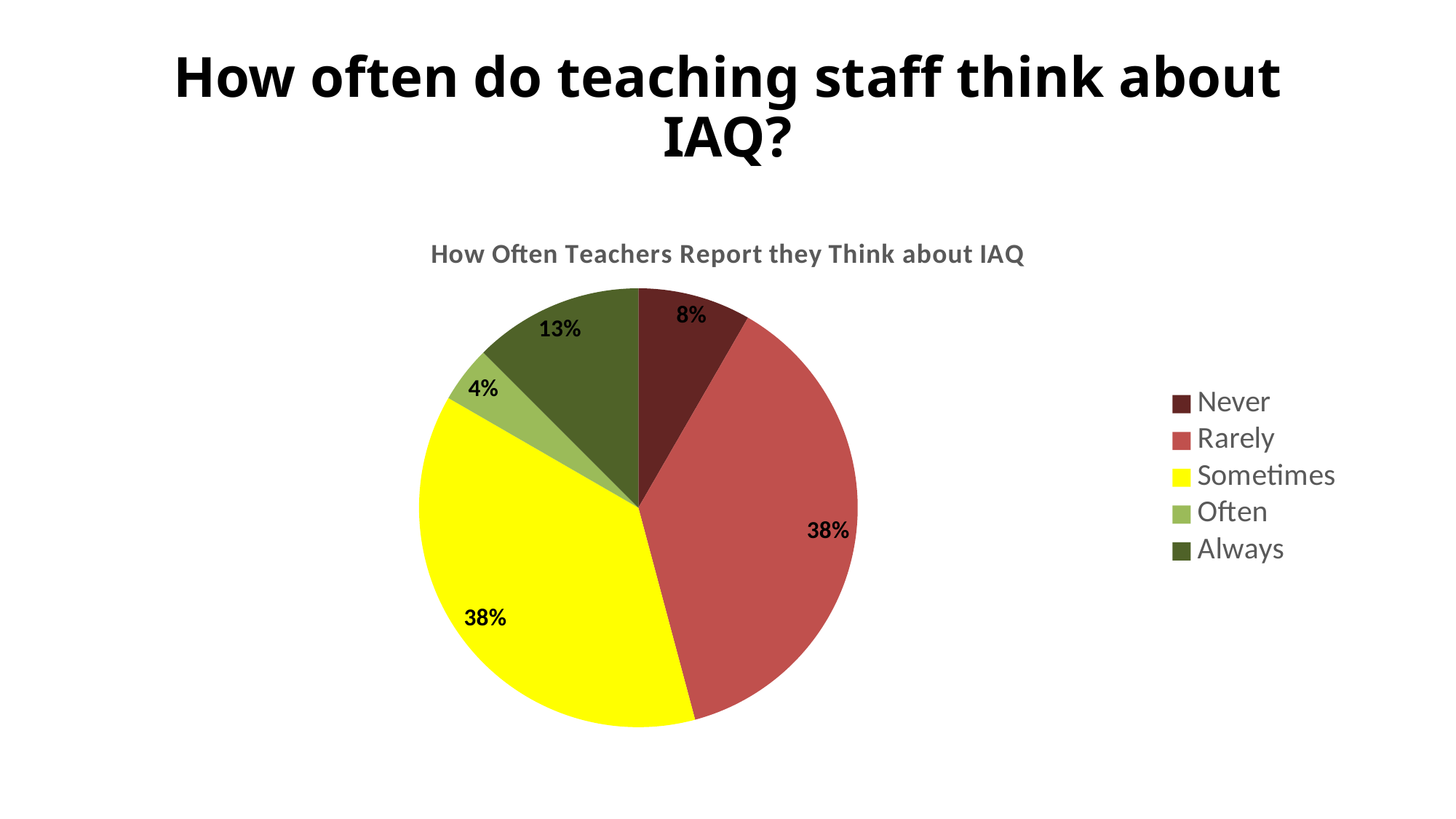
What is the chart's title? How Often Teachers Report they Think about IAQ What colour is the Sometimes slice? yellow What is the difference in percentage points between the Sometimes and Often slices? 34 Which category has the smallest share of the pie? Often What percentage of teachers report they Never think about IAQ? 8% What is the difference in percentage points between the Always and Never slices? 5 What kind of chart is shown on the slide? pie chart What percentage of teachers report they Always think about IAQ? 13% How many categories does the legend list? 5 What percentage of teachers report they Rarely think about IAQ? 38% What percentage of teachers report they Often think about IAQ? 4% Which is larger, the Always slice or the Never slice? Always